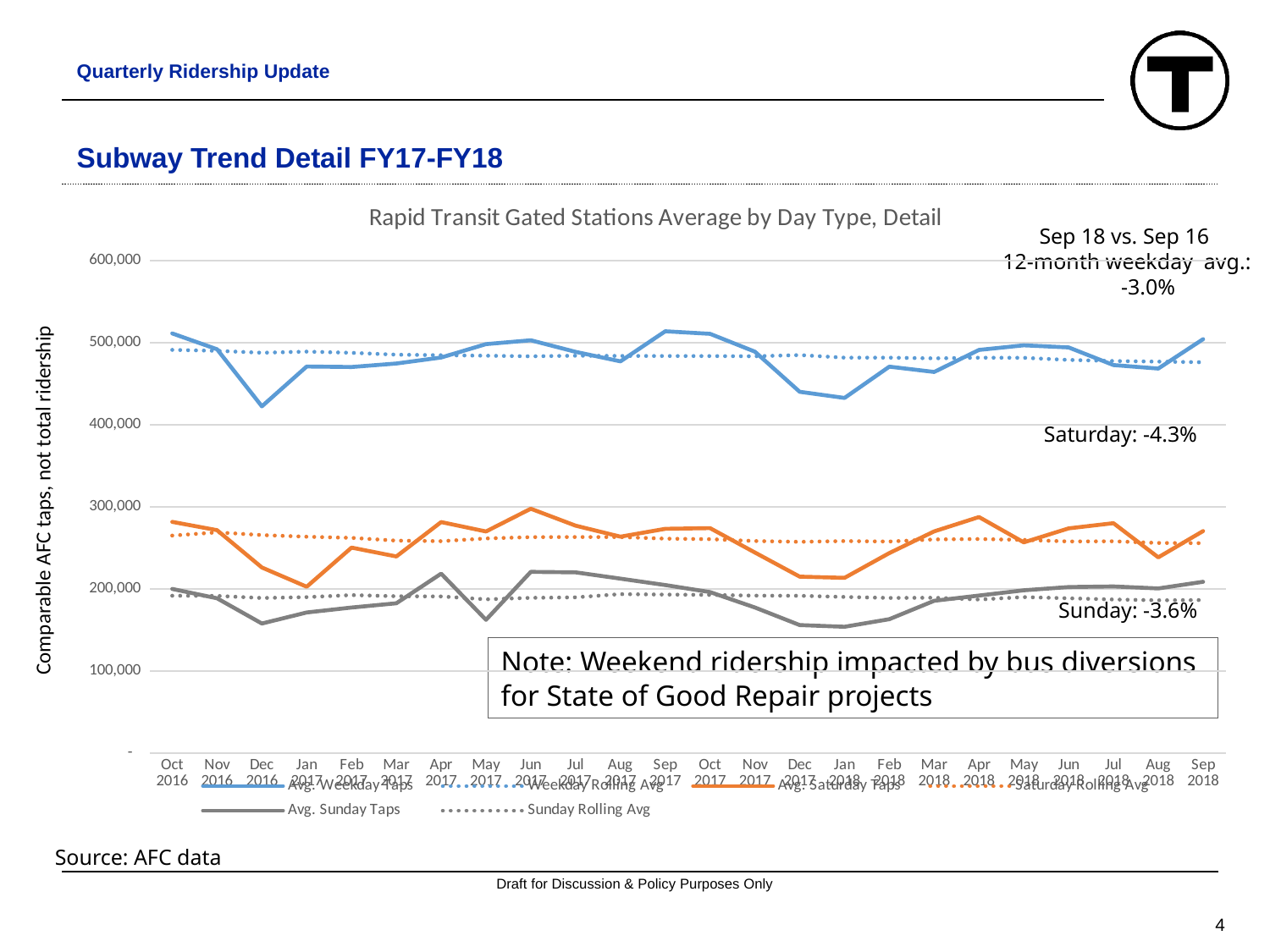
Which is larger for Avg. Sunday Taps: Dec 2016 or Jun 2017? Jun 2017 Which is larger in Sep 2018: Avg. Weekday Taps or Avg. Saturday Taps? Avg. Weekday Taps Is the value for Avg. Weekday Taps in Dec 2016 greater or less than 400,000? greater Is the value for Avg. Sunday Taps in Dec 2016 greater or less than 200,000? less How many months are plotted along the x axis of the chart? 24 What is the title of the chart? Rapid Transit Gated Stations Average by Day Type, Detail How many series does the chart legend list? 6 Is the value for Avg. Weekday Taps in Dec 2016 greater or less than 500,000? less What kind of chart is shown on the slide? line chart According to the annotation on the chart, what is the Saturday change for Sep 18 vs. Sep 16? -4.3%